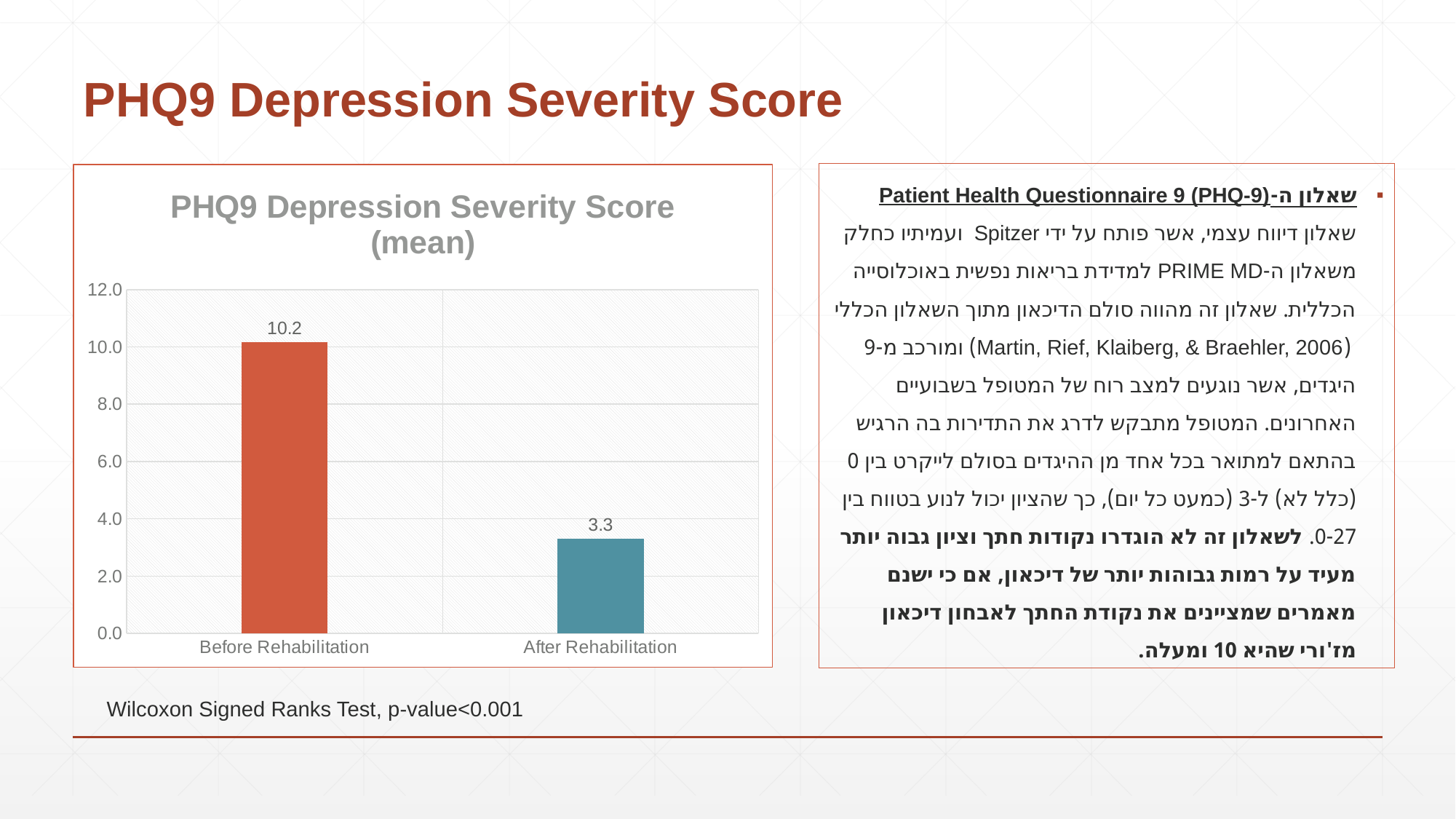
What is the difference between the mean PHQ9 score before and after rehabilitation? 6.9 Is the value for Before Rehabilitation greater or less than 8.0? greater Do the values rise or fall from Before Rehabilitation to After Rehabilitation? Fall How many categories are shown on the x axis of the chart? 2 What kind of chart is shown on the slide? Bar chart What is the mean PHQ9 Depression Severity Score after rehabilitation? 3.3 Is the mean PHQ9 score larger before or after rehabilitation? Before Rehabilitation Is the value for After Rehabilitation greater or less than 4.0? less What is the title of the chart? PHQ9 Depression Severity Score (mean) Which category has the higher mean PHQ9 score? Before Rehabilitation What is the mean PHQ9 Depression Severity Score before rehabilitation? 10.2 Which category has the lower mean PHQ9 score? After Rehabilitation